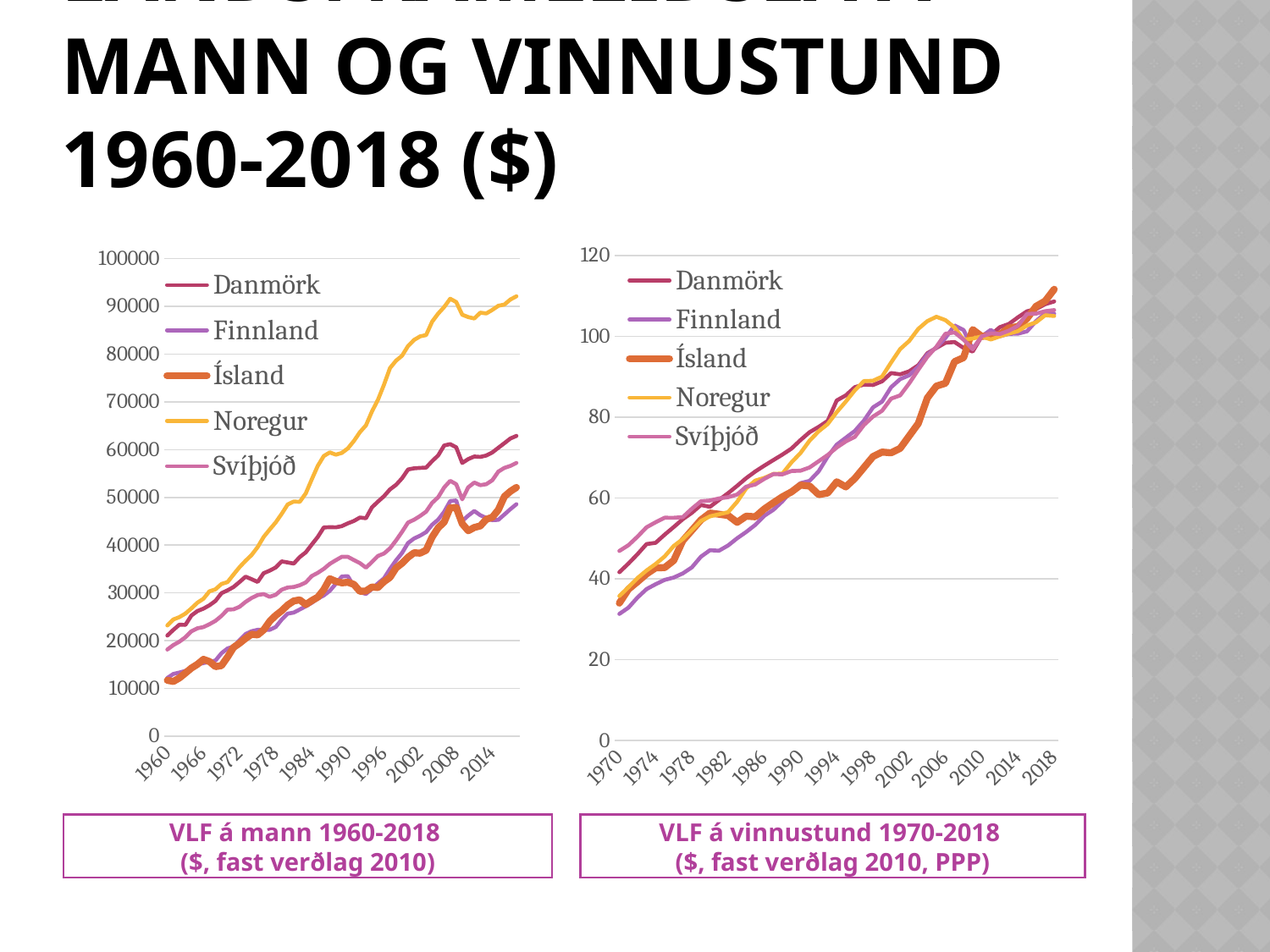
In the left chart, 'VLF á mann 1960-2018', is the value for Noregur at the end of the period greater or less than 80000? greater In the left chart, 'VLF á mann 1960-2018', which country has the highest value at the end of the period? Noregur In the right chart, 'VLF á vinnustund 1970-2018', which country has the highest value in 1970? Svíþjóð In the right chart, 'VLF á vinnustund 1970-2018', is the value for Finnland in 1970 greater or less than 40? less In the right chart, 'VLF á vinnustund 1970-2018', do the values for Ísland generally rise or fall from 1970 to 2018? Rise What is the title shown below the right chart? VLF á vinnustund 1970-2018 ($, fast verðlag 2010, PPP) In the right chart, 'VLF á vinnustund 1970-2018', is the peak value for Noregur around 2006 greater or less than 100? greater How many series does the legend of the right chart, 'VLF á vinnustund 1970-2018', list? 5 What type of chart is the left chart, 'VLF á mann 1960-2018'? Line chart In the left chart, 'VLF á mann 1960-2018', which is larger in 1990: Noregur or Finnland? Noregur